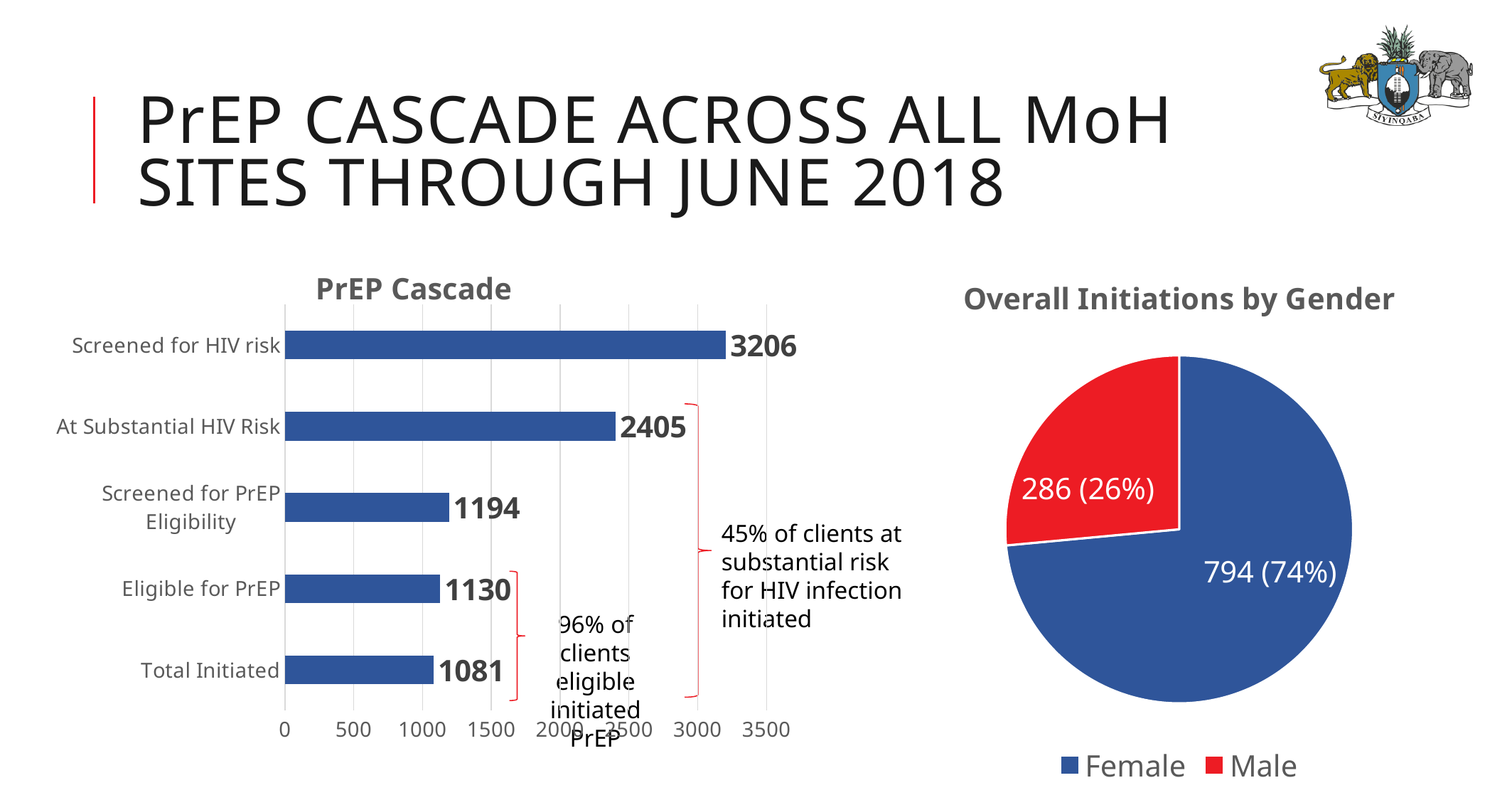
What kind of chart is the PrEP Cascade chart? Bar chart In the Overall Initiations by Gender chart, what share of initiations is Female? 74% In the Overall Initiations by Gender chart, what is the value for Male? 286 (26%) In the PrEP Cascade chart, which category has the lowest value? Total Initiated In the PrEP Cascade chart, what is the value for Screened for PrEP Eligibility? 1194 In the PrEP Cascade chart, how many categories are shown? 5 In the PrEP Cascade chart, what is the value for Screened for HIV risk? 3206 In the Overall Initiations by Gender chart, how many entries does the legend list? 2 In the PrEP Cascade chart, what is the value for Total Initiated? 1081 In the PrEP Cascade chart, what is the difference between Screened for HIV risk and At Substantial HIV Risk? 801 In the PrEP Cascade chart, what is the difference between Eligible for PrEP and Total Initiated? 49 In the PrEP Cascade chart, which category has the highest value? Screened for HIV risk